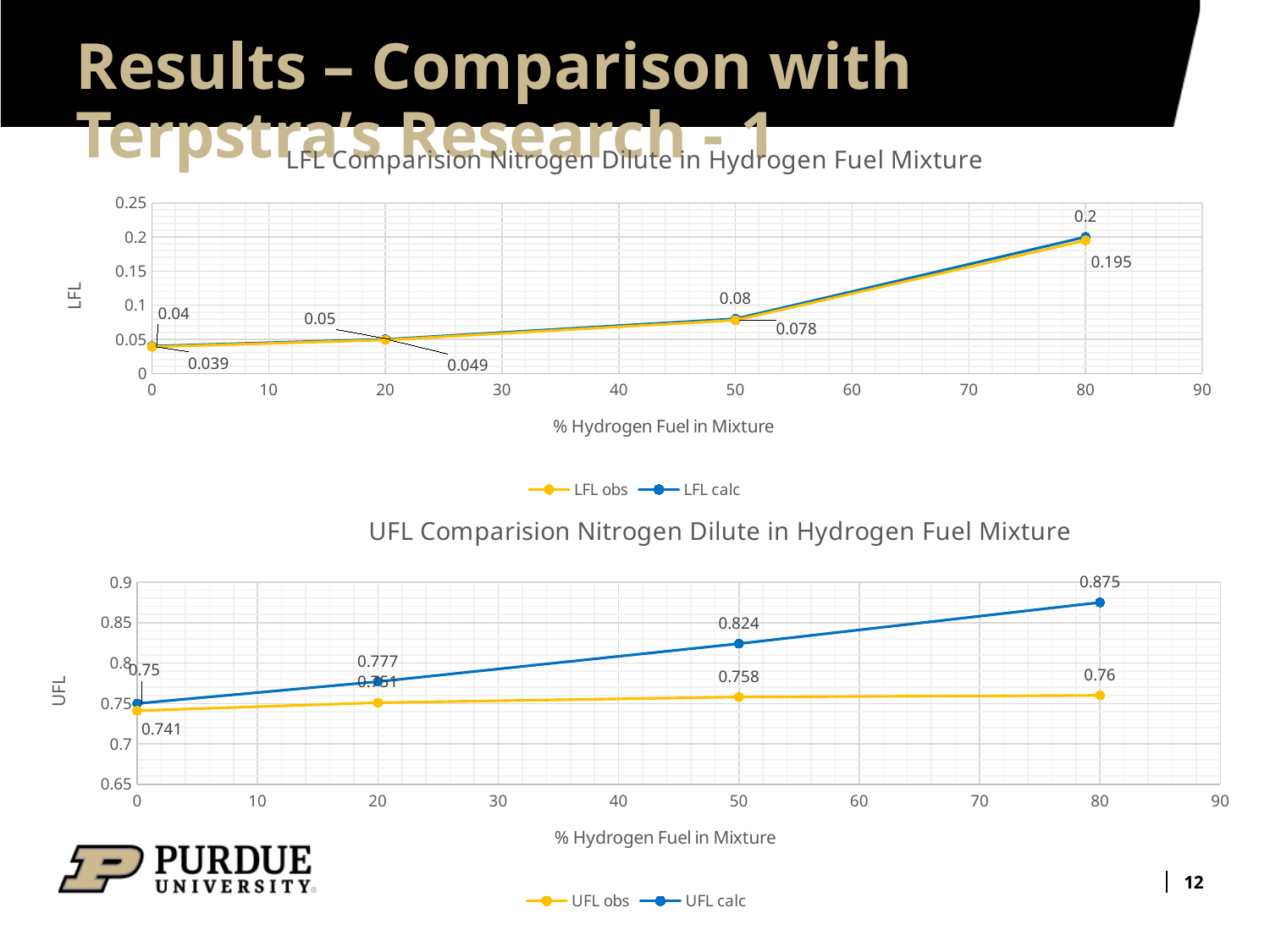
In the UFL Comparision chart, what is the UFL calc value at 50% hydrogen fuel in mixture? 0.824 In the LFL Comparision chart, what is the difference between LFL calc and LFL obs at 80% hydrogen fuel in mixture? 0.005 In the UFL Comparision chart, what is the difference between UFL calc and UFL obs at 80% hydrogen fuel in mixture? 0.115 What kind of chart is the LFL Comparision Nitrogen Dilute in Hydrogen Fuel Mixture chart? Line chart How many series does the legend of the LFL Comparision chart list? 2 In the UFL Comparision chart, how many data points does the UFL calc series have? 4 In the LFL Comparision chart, what is the LFL calc value at 80% hydrogen fuel in mixture? 0.2 In the UFL Comparision chart, what is the UFL obs value at 80% hydrogen fuel in mixture? 0.76 In the UFL Comparision chart, is the UFL obs value at 50% hydrogen fuel in mixture greater or less than 0.8? less In the LFL Comparision chart, what is the LFL obs value at 80% hydrogen fuel in mixture? 0.195 In the UFL Comparision chart, which series has the larger value at 80% hydrogen fuel in mixture, UFL obs or UFL calc? UFL calc In the LFL Comparision chart, does the LFL calc series rise or fall as % hydrogen fuel in mixture increases? Rises